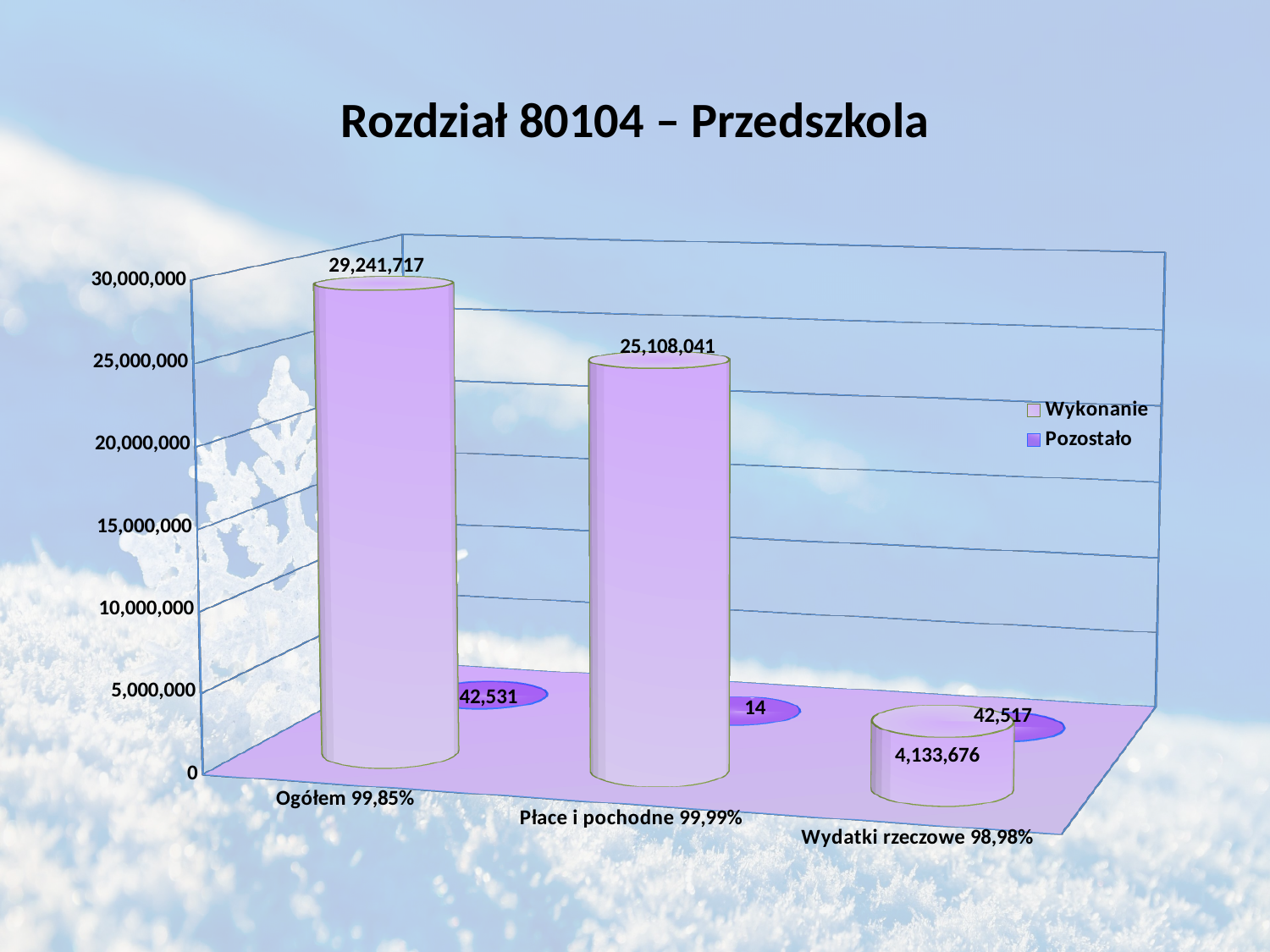
What is the Pozostało value for Płace i pochodne 99,99%? 14 What is the Wykonanie value for Płace i pochodne 99,99%? 25,108,041 What is the title of the chart? Rozdział 80104 – Przedszkola What is the Wykonanie value for Wydatki rzeczowe 98,98%? 4,133,676 How many series does the legend list? 2 Which category has the lowest Pozostało value? Płace i pochodne 99,99% What is the Pozostało value for Wydatki rzeczowe 98,98%? 42,517 What is the Wykonanie value for Ogółem 99,85%? 29,241,717 What is the difference between the Wykonanie values for Ogółem 99,85% and Płace i pochodne 99,99%? 4,133,676 Which category has the highest Wykonanie value? Ogółem 99,85% Is the Wykonanie value for Wydatki rzeczowe 98,98% greater or less than 5,000,000? less What is the Pozostało value for Ogółem 99,85%? 42,531